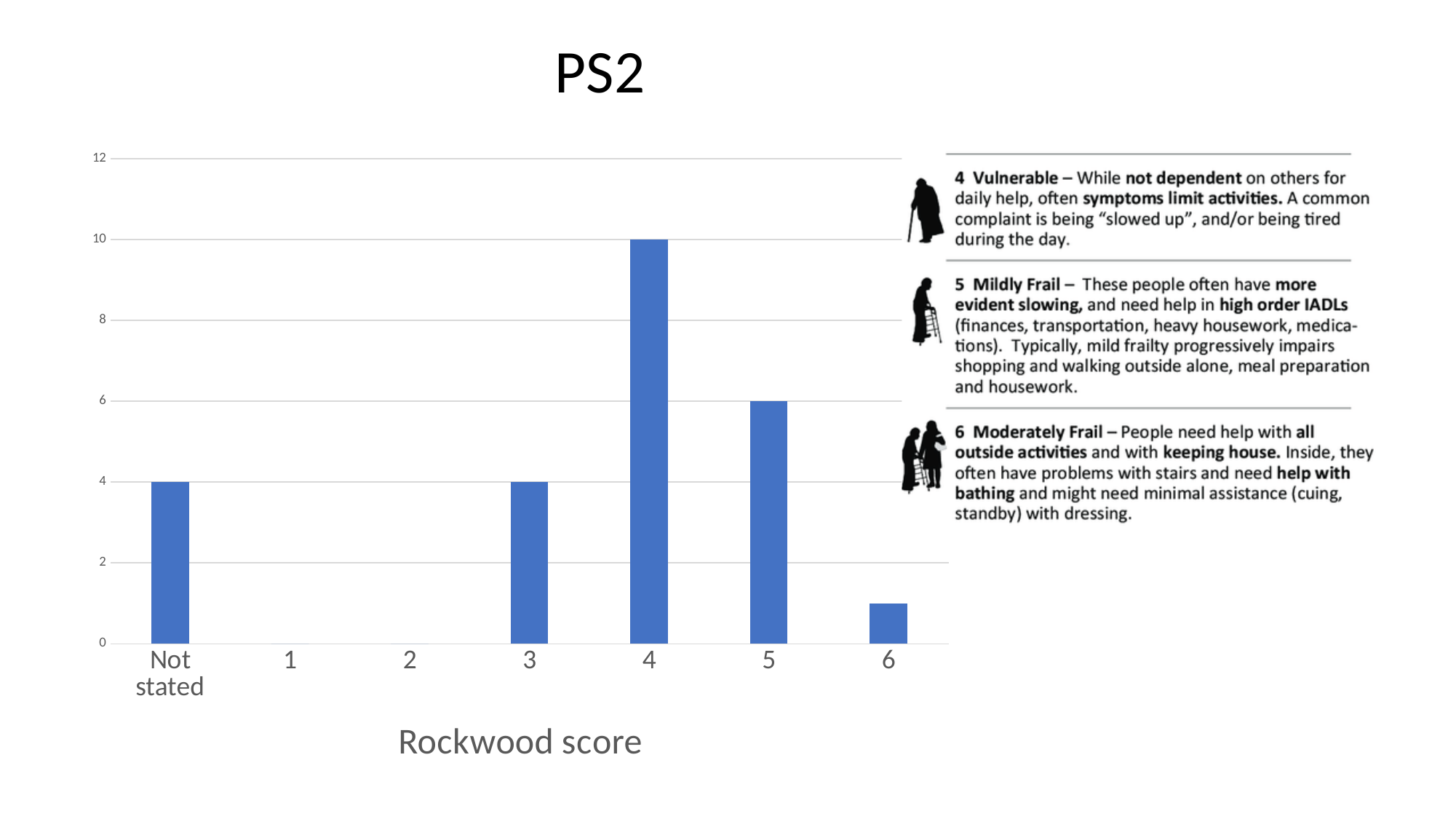
What is the value for the 'Not stated' category? 4 How many categories are shown on the x axis of the chart? 7 What is the value for Rockwood score 5? 6 What is the value for Rockwood score 3? 4 What is the title shown at the top of the slide? PS2 What is the x-axis title of the chart? Rockwood score Which is larger, the value for Rockwood score 3 or for Rockwood score 5? 5 Is the value for Rockwood score 6 greater or less than 2? less What kind of chart is shown on the slide? bar chart What is the difference between the value for Rockwood score 4 and the value for Rockwood score 5? 4 What is the value for Rockwood score 4? 10 Which Rockwood score category has the highest bar? 4